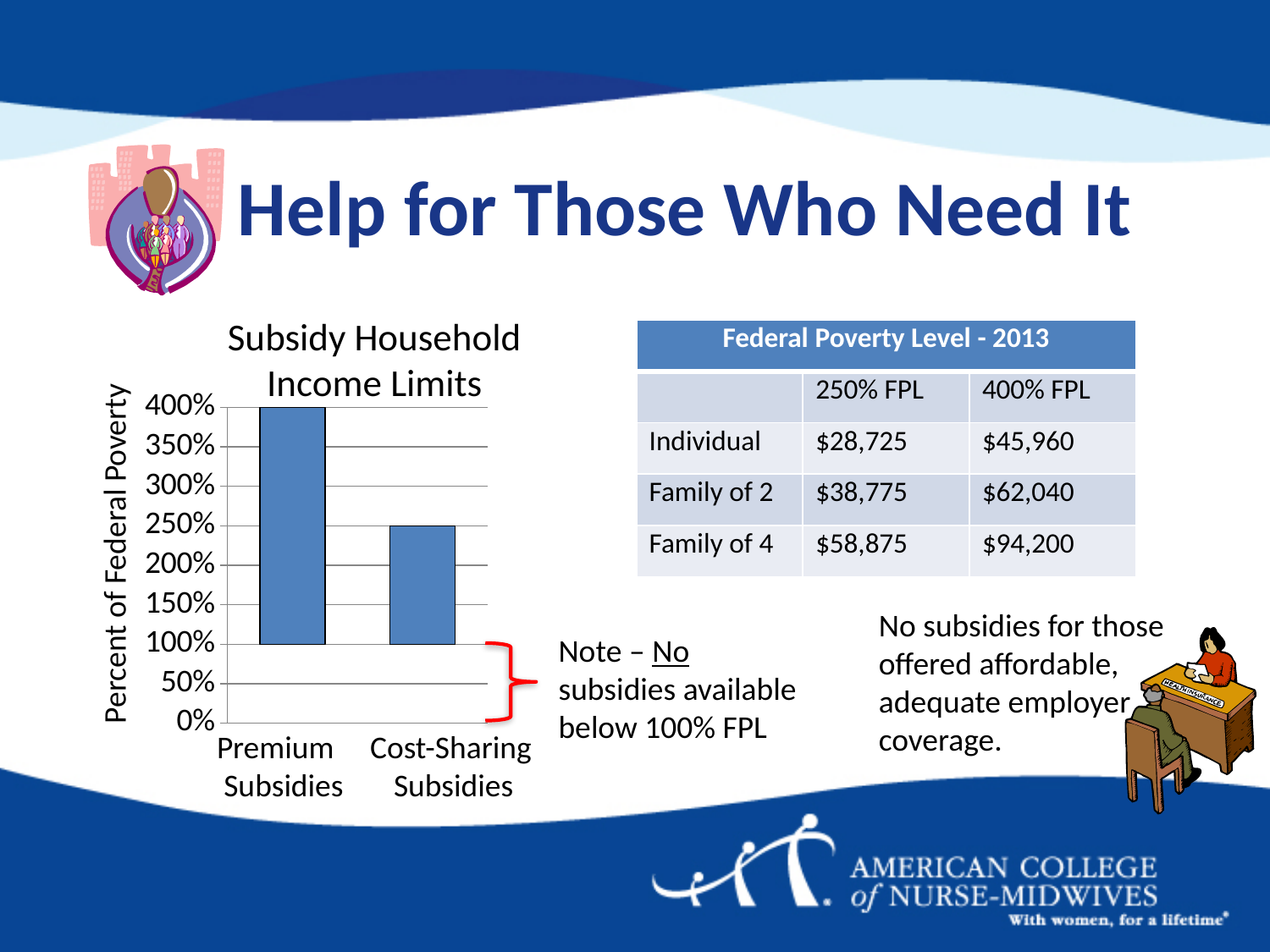
What is the upper income limit for Premium Subsidies in the chart? 400% At what percent of federal poverty do both bars in the chart begin? 100% Is the upper limit for Premium Subsidies greater or less than 350%? greater What is the title of the chart on the slide? Subsidy Household Income Limits What type of chart is shown on the slide? bar chart Which category has the higher upper income limit in the chart? Premium Subsidies What is the label of the y axis of the chart? Percent of Federal Poverty Is the upper limit for Cost-Sharing Subsidies greater or less than 300%? less Which category has the lower upper income limit in the chart? Cost-Sharing Subsidies How many categories are shown on the x axis of the chart? 2 What is the upper income limit for Cost-Sharing Subsidies in the chart? 250% What is the difference between the upper income limits for Premium Subsidies and Cost-Sharing Subsidies? 150%